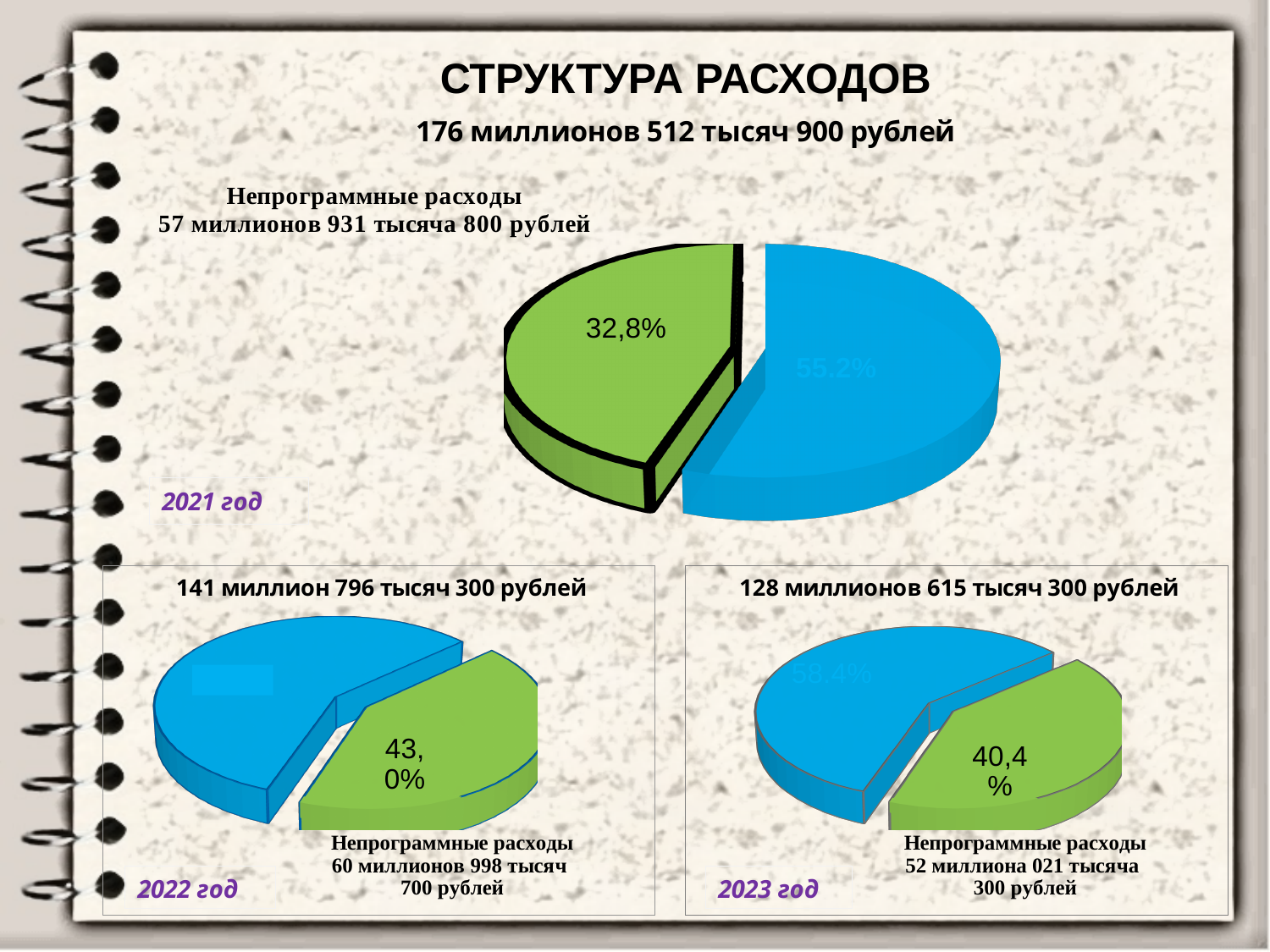
In the 2021 pie chart, what share is shown for the green slice (Непрограммные расходы)? 32,8% In the 2023 pie chart, which slice is larger, the blue one or the green one? blue In the 2023 pie chart, what share is shown for the green slice (Непрограммные расходы)? 40,4% In the 2021 pie chart, which slice is larger, the blue one or the green one? blue What kind of chart is used on the slide for the 2021 year? pie chart What is the title of the slide? СТРУКТУРА РАСХОДОВ How many slices does the 2021 pie chart have? 2 In the 2022 pie chart, which slice is larger, the blue one or the green one? blue In the 2022 pie chart, what share is shown for the green slice (Непрограммные расходы)? 43,0% Which year's pie chart has the largest green slice (Непрограммные расходы) share? 2022 How many pie charts are shown on the slide? 3 What total amount is shown above the 2022 pie chart? 141 миллион 796 тысяч 300 рублей